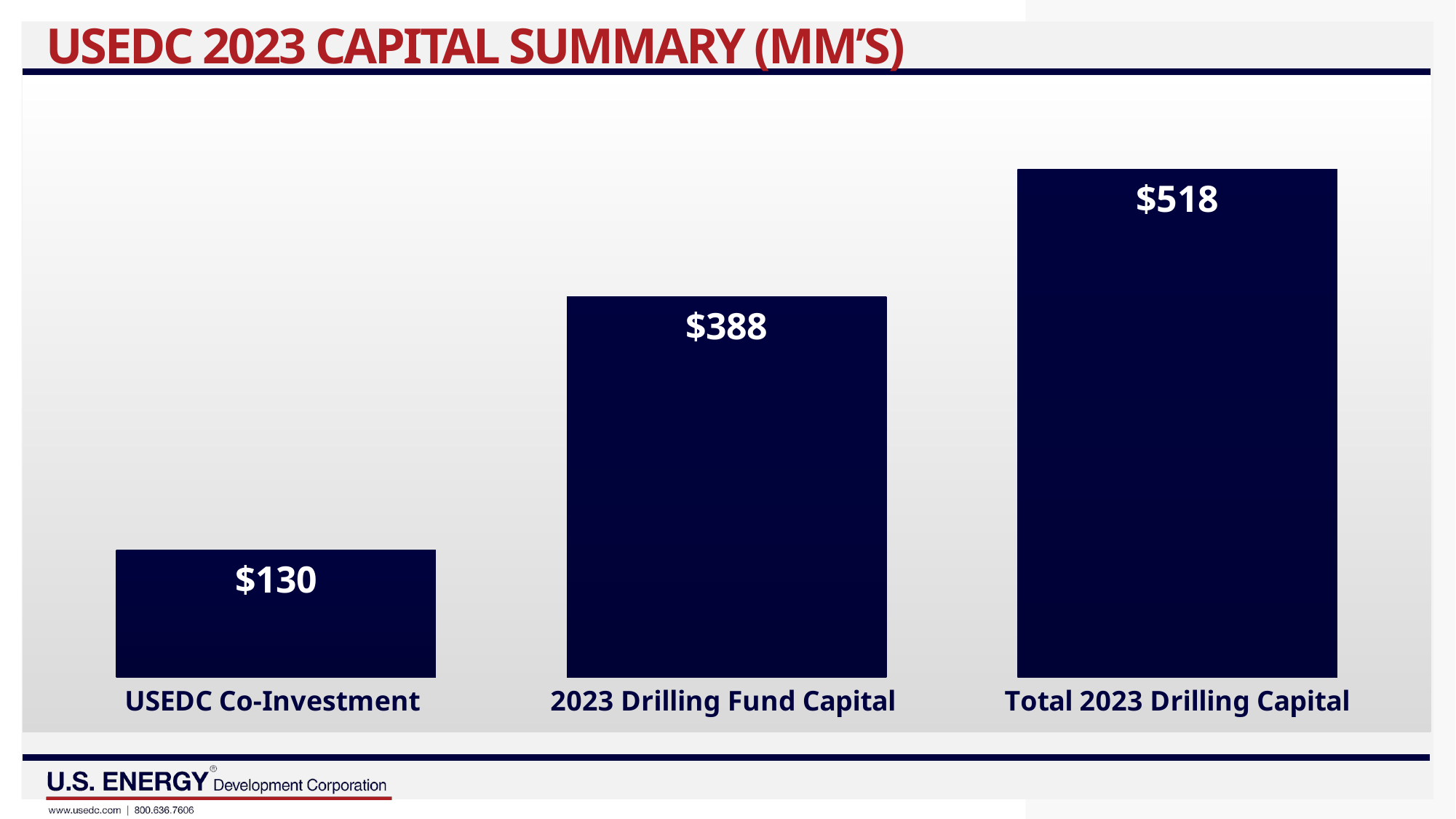
Do the values rise or fall from left to right across the categories? Rise What is the title of the chart? USEDC 2023 CAPITAL SUMMARY (MM'S) What kind of chart is shown on the slide? Bar chart Which is larger, USEDC Co-Investment or 2023 Drilling Fund Capital? 2023 Drilling Fund Capital Which category has the lowest value? USEDC Co-Investment What is the difference between Total 2023 Drilling Capital and 2023 Drilling Fund Capital? $130 What is the value for USEDC Co-Investment? $130 Which category has the highest value? Total 2023 Drilling Capital What is the value for Total 2023 Drilling Capital? $518 How many categories are shown in the chart? 3 What is the difference between 2023 Drilling Fund Capital and USEDC Co-Investment? $258 What is the value for 2023 Drilling Fund Capital? $388